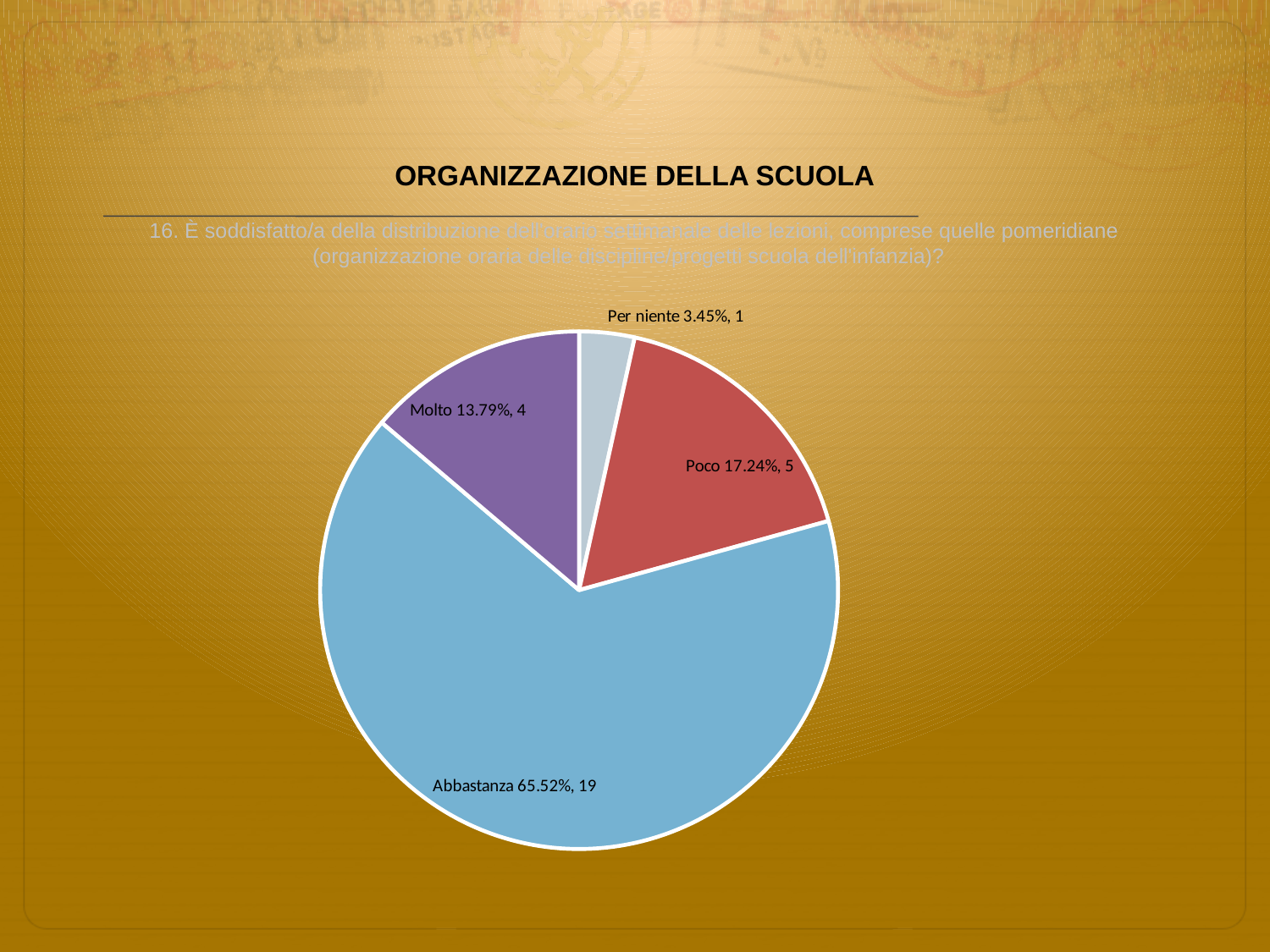
Which category has the largest slice? Abbastanza What percentage share does the Abbastanza slice have? 65.52% Which category has the smallest slice? Per niente Which is larger, the Poco slice or the Molto slice? Poco How many slices does the pie chart have? 4 What colour is the Abbastanza slice? light blue What is the difference in count between Abbastanza and Poco? 14 What is the count shown for Per niente? 1 What is the total count across all slices? 29 What kind of chart is shown on the slide? pie chart What is the count shown for Poco? 5 What percentage is shown for Molto? 13.79%